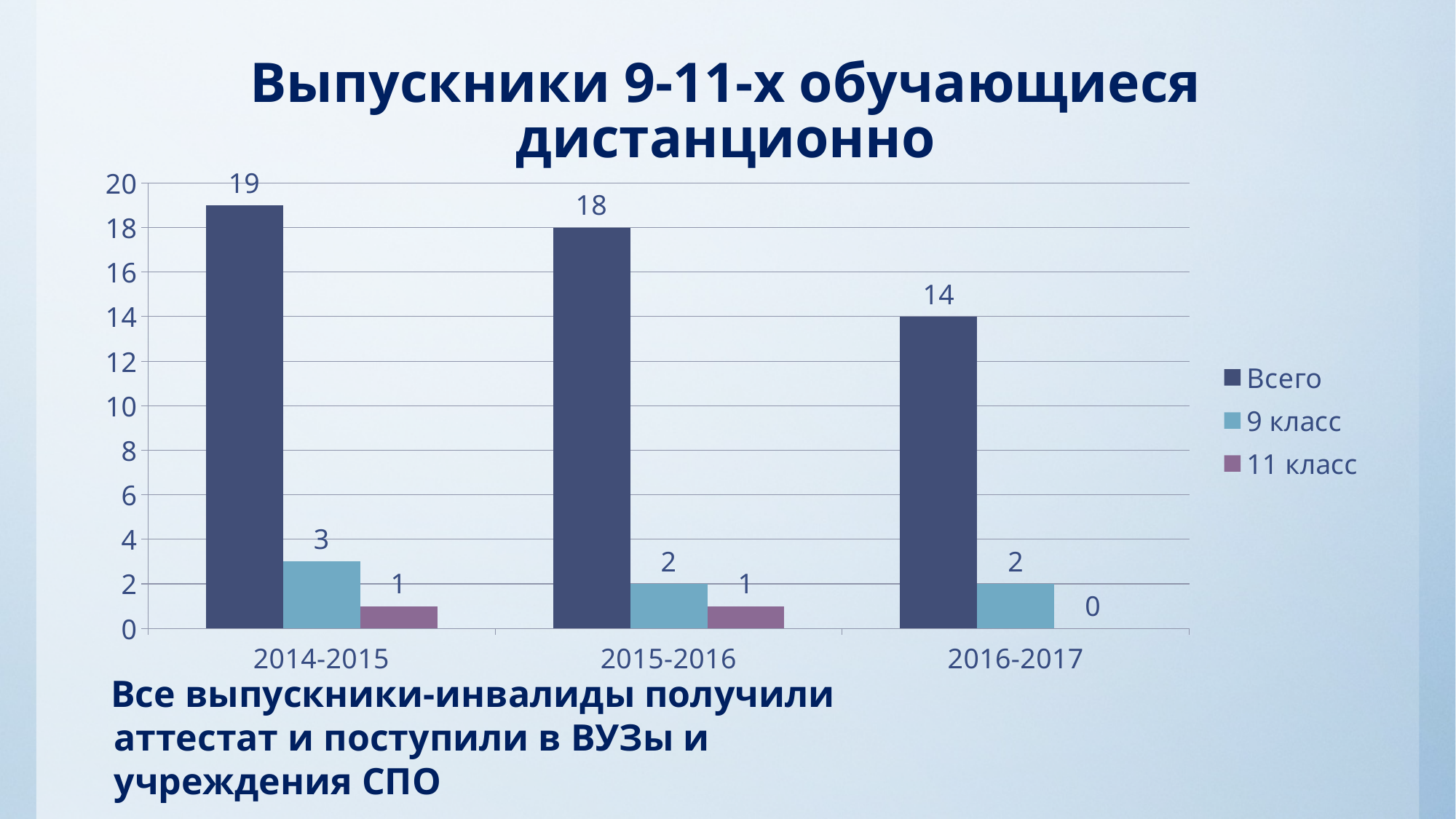
How many year categories are shown on the x axis? 3 Which is larger: 9 класс in 2014-2015 or 9 класс in 2016-2017? 9 класс in 2014-2015 What kind of chart is shown on the slide? Bar chart What is the value of 11 класс for 2016-2017? 0 What is the value of Всего for 2014-2015? 19 Which year has the highest value for Всего? 2014-2015 What is the difference between Всего in 2014-2015 and Всего in 2016-2017? 5 How many series does the legend list? 3 What is the value of 9 класс for 2015-2016? 2 What is the value of Всего for 2016-2017? 14 Which year has the lowest value for Всего? 2016-2017 Does the value of Всего rise or fall from 2014-2015 to 2016-2017? Fall